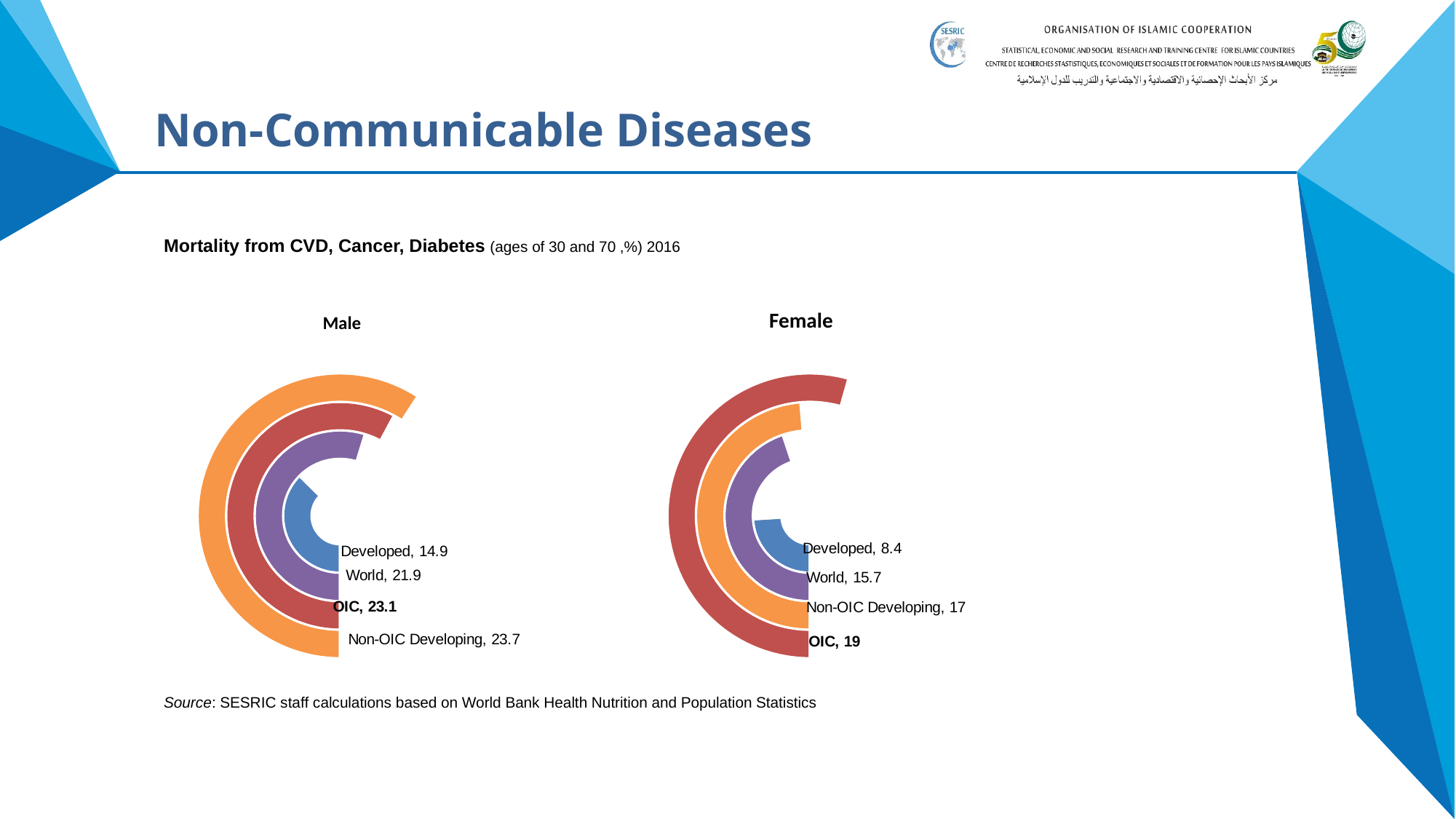
In the Female chart, which is larger, the value for OIC or the value for Non-OIC Developing? OIC How many categories are shown in the Male chart? 4 In the Male chart, what is the difference between the Non-OIC Developing and OIC values? 0.6 In the Male chart, what is the value for OIC? 23.1 In the Male chart, which category has the lowest value? Developed In the Female chart, which category has the highest value? OIC In the Female chart, what is the value for World? 15.7 In the Female chart, what is the value for Developed? 8.4 In the Male chart, what colour is the ring for Developed? Blue In the Female chart, what is the difference between the OIC and Developed values? 10.6 In the Male chart, what is the value for Non-OIC Developing? 23.7 What is the title of the Male chart's parent figure on the slide? Mortality from CVD, Cancer, Diabetes